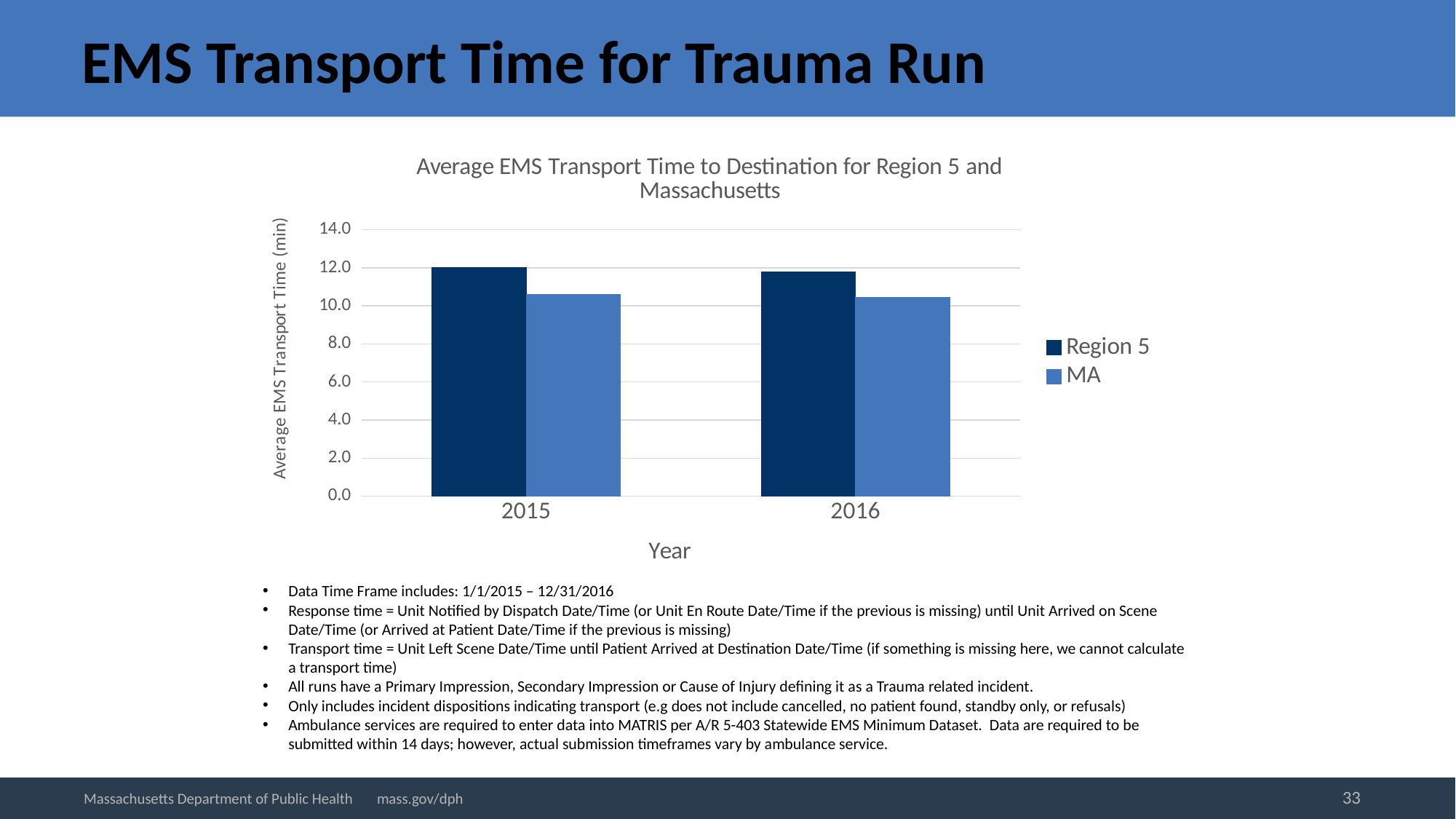
How many years are shown on the x axis? 2 Which series has the lowest bar on the chart? MA Is the value for Region 5 in 2015 greater or less than 10.0? greater Is the value for MA in 2016 greater or less than 12.0? less How many series does the legend list? 2 What is the label of the y axis? Average EMS Transport Time (min) In 2016, which is larger, the average transport time for Region 5 or for MA? Region 5 Is the value for Region 5 in 2016 greater or less than 8.0? greater What is the title of the chart? Average EMS Transport Time to Destination for Region 5 and Massachusetts In 2015, which is larger, the average transport time for Region 5 or for MA? Region 5 What kind of chart is shown on the slide? bar chart